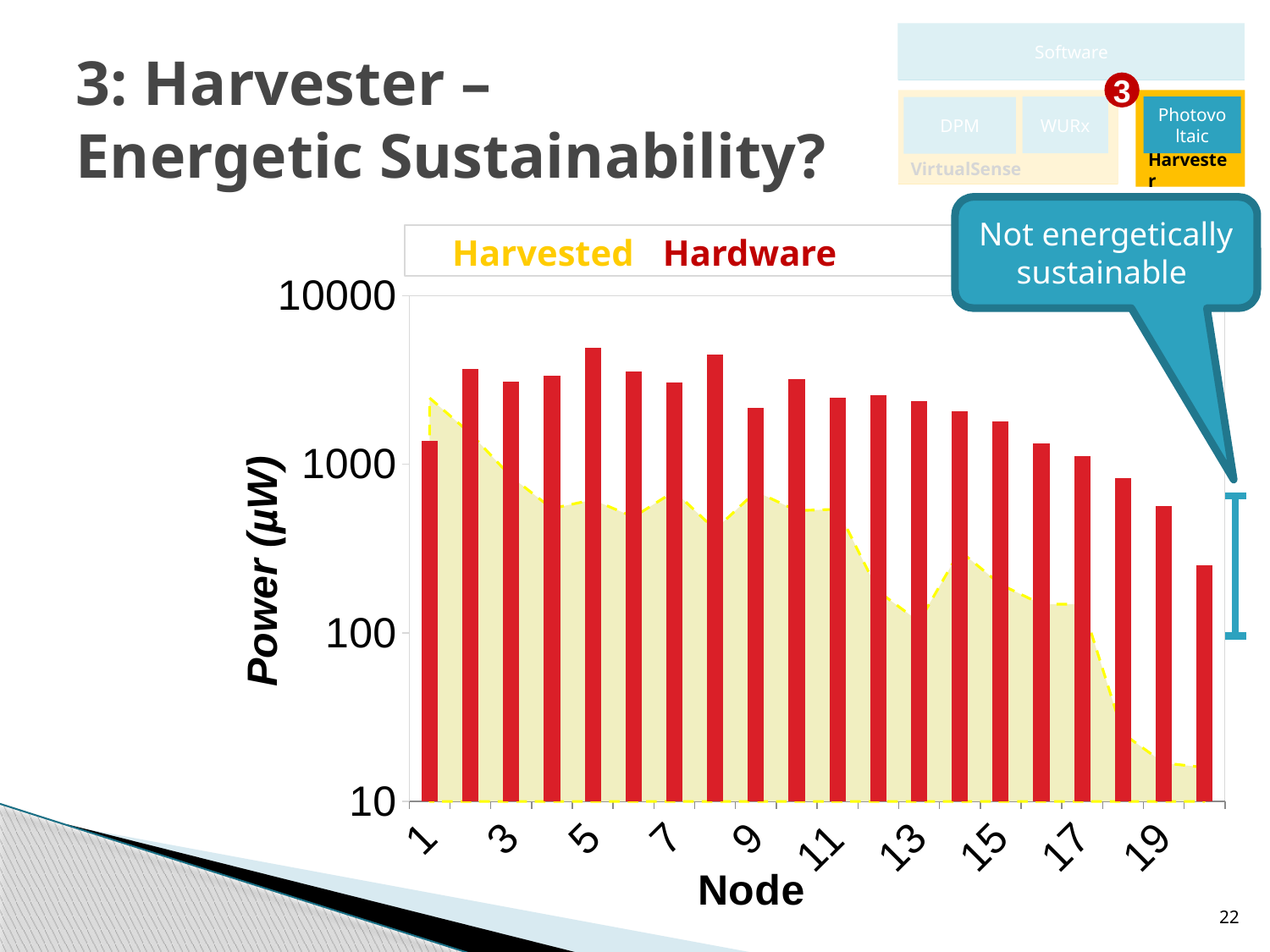
At node 10, which series has the larger value, Harvested or Hardware? Hardware Is the Hardware value for node 5 greater or less than 1000? greater Is the Harvested value for node 20 greater or less than 100? less What kind of chart is used to plot the Hardware series? bar chart Which node has the highest Hardware power value? Node 5 At node 1, which series has the larger value, Harvested or Hardware? Harvested How many nodes are plotted along the x axis? 20 Do the Hardware values rise or fall from node 10 to node 20? fall How many series does the legend list? 2 Which node has the lowest Hardware power value? Node 20 What is the label of the y axis? Power (µW) Is the Hardware value for node 20 greater or less than 1000? less